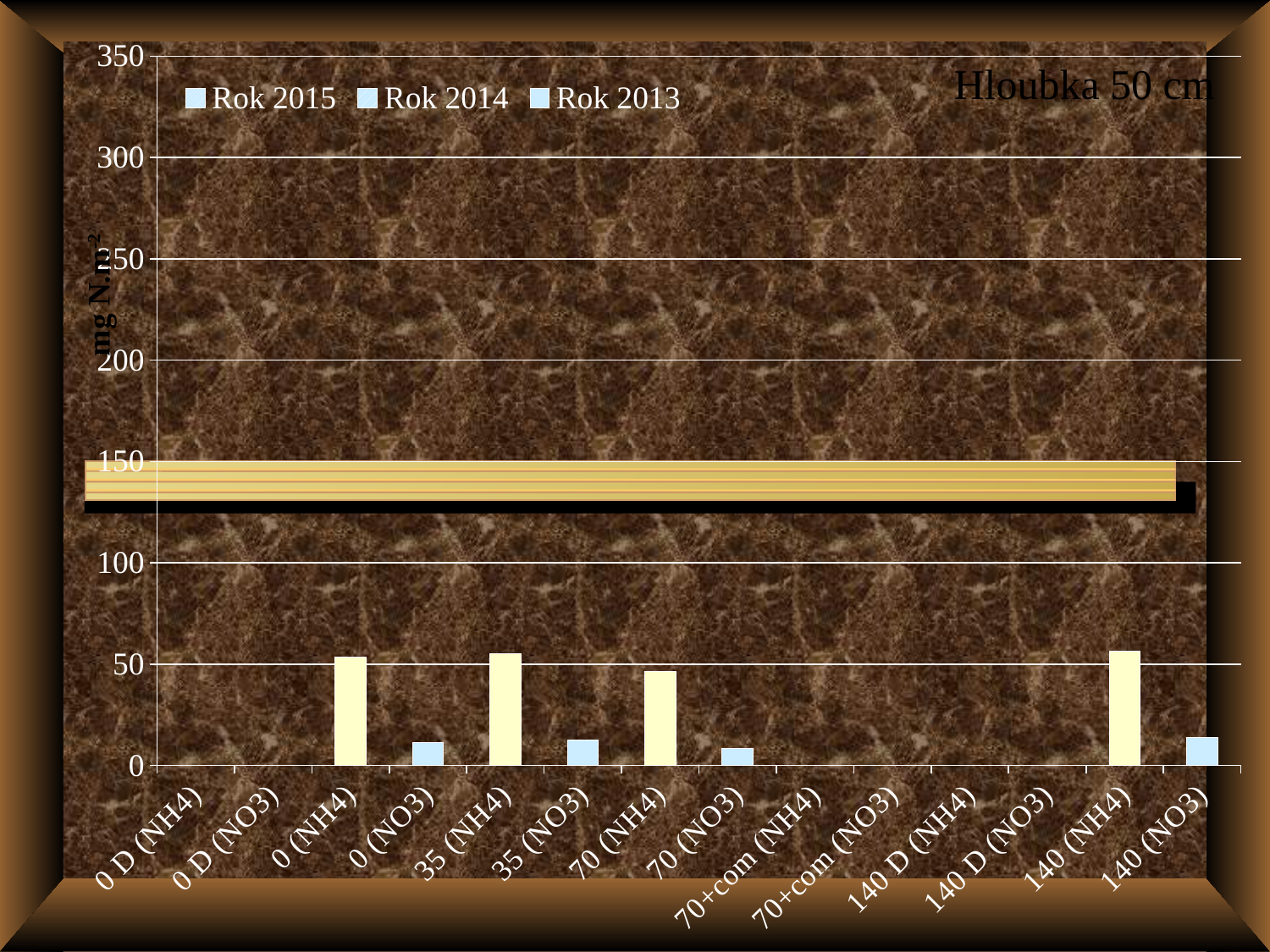
What is the label on the vertical axis of the chart? mg N.m² Which is larger, the value for 140 (NH4) or the value for 140 (NO3)? 140 (NH4) How many categories are listed along the x axis of the chart? 14 Is the value for 0 (NO3) greater or less than 50? less Is the value for 140 (NH4) greater or less than 50? greater Is the value for 0 (NH4) greater or less than 100? less How many series does the chart legend list? 3 What is the title shown in the top right corner of the chart? Hloubka 50 cm Which is larger, the value for 35 (NH4) or the value for 70 (NH4)? 35 (NH4) What kind of chart is shown on the slide? bar chart Which is larger, the value for 70 (NH4) or the value for 70 (NO3)? 70 (NH4)